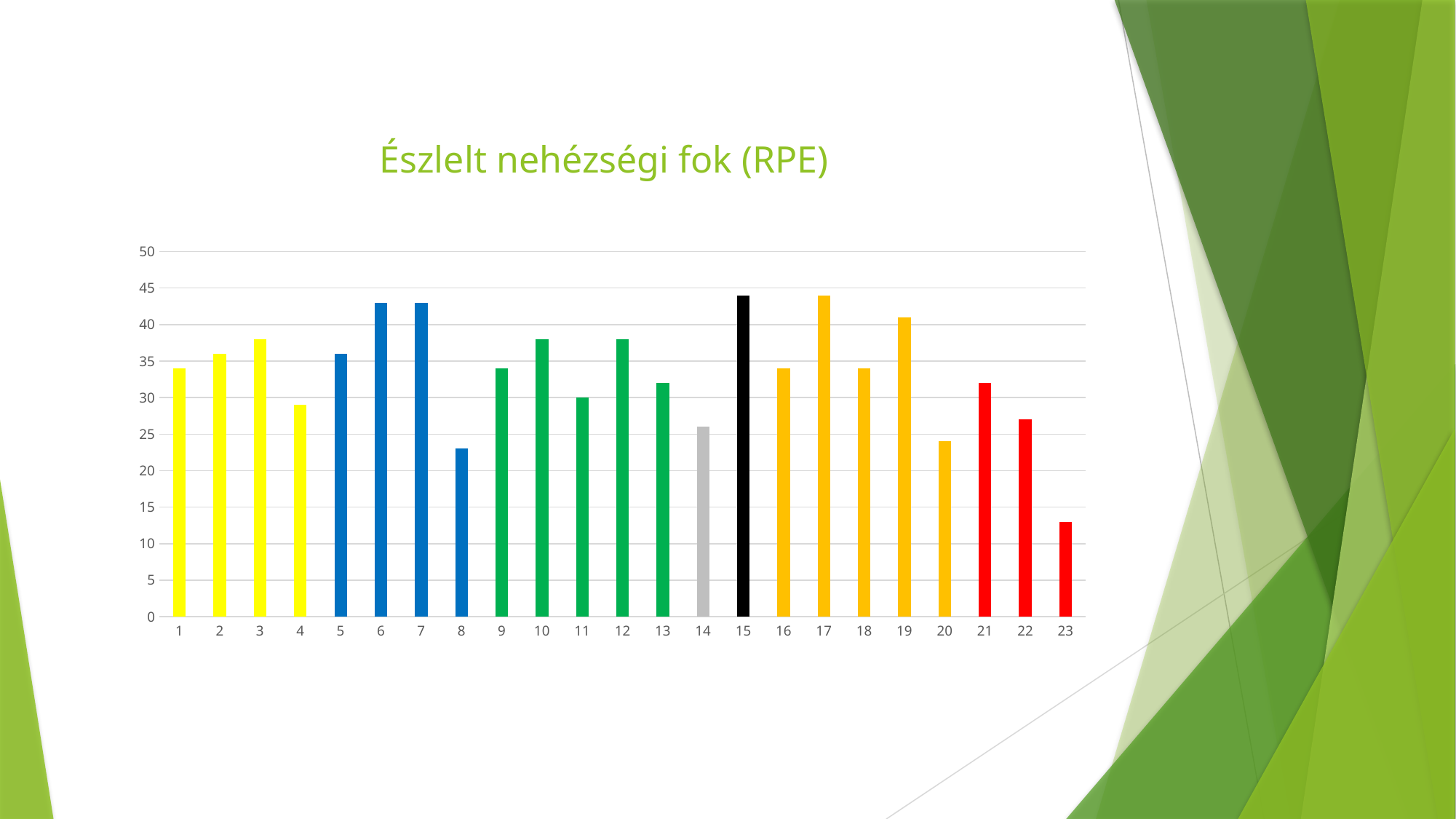
Is the value for category 15 greater or less than 40? greater Is the value for category 23 greater or less than 15? less Is the value for category 4 greater or less than 30? less What colour are the bars for categories 21 to 23? red Which has the larger value, category 6 or category 8? 6 What is the title of the chart? Észlelt nehézségi fok (RPE) What kind of chart is shown on the slide? bar chart How many bars (categories) are plotted in the chart? 23 Which category has the lowest value in the chart? 23